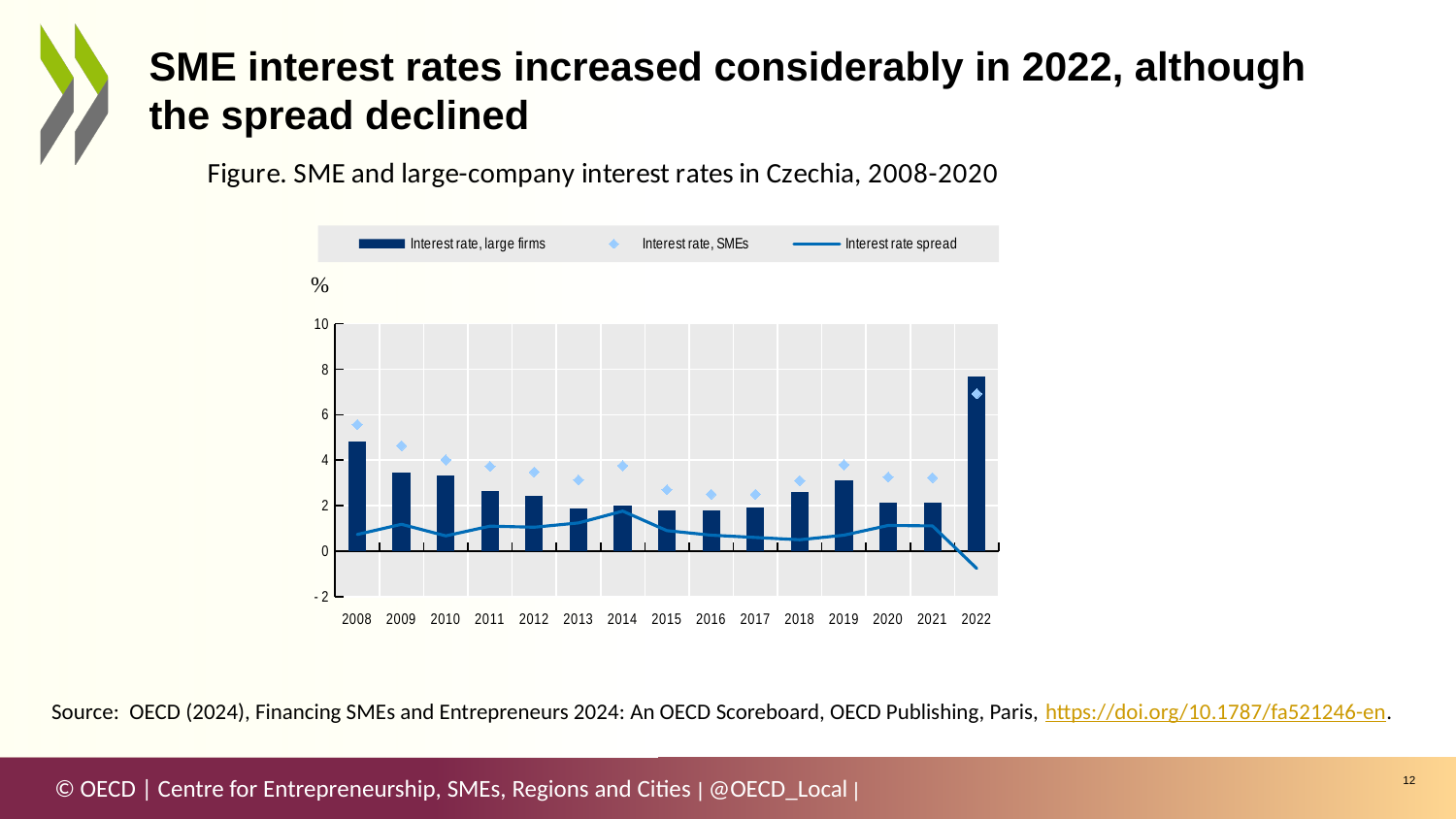
How many series does the chart legend list? 3 In which year is the interest rate for SMEs highest? 2022 Is the interest rate spread in 2022 greater or less than 0? less Is the interest rate for large firms in 2016 greater or less than 2? less What is the title of the figure on the slide? Figure. SME and large-company interest rates in Czechia, 2008-2020 Which is larger, the interest rate for large firms in 2019 or in 2020? 2019 Is the interest rate for SMEs in 2008 greater or less than 4? greater What unit is shown on the y axis of the chart? % How many years are shown on the x axis of the chart? 15 In which year is the interest rate for large firms highest? 2022 Does the interest rate spread rise or fall from 2021 to 2022? fall